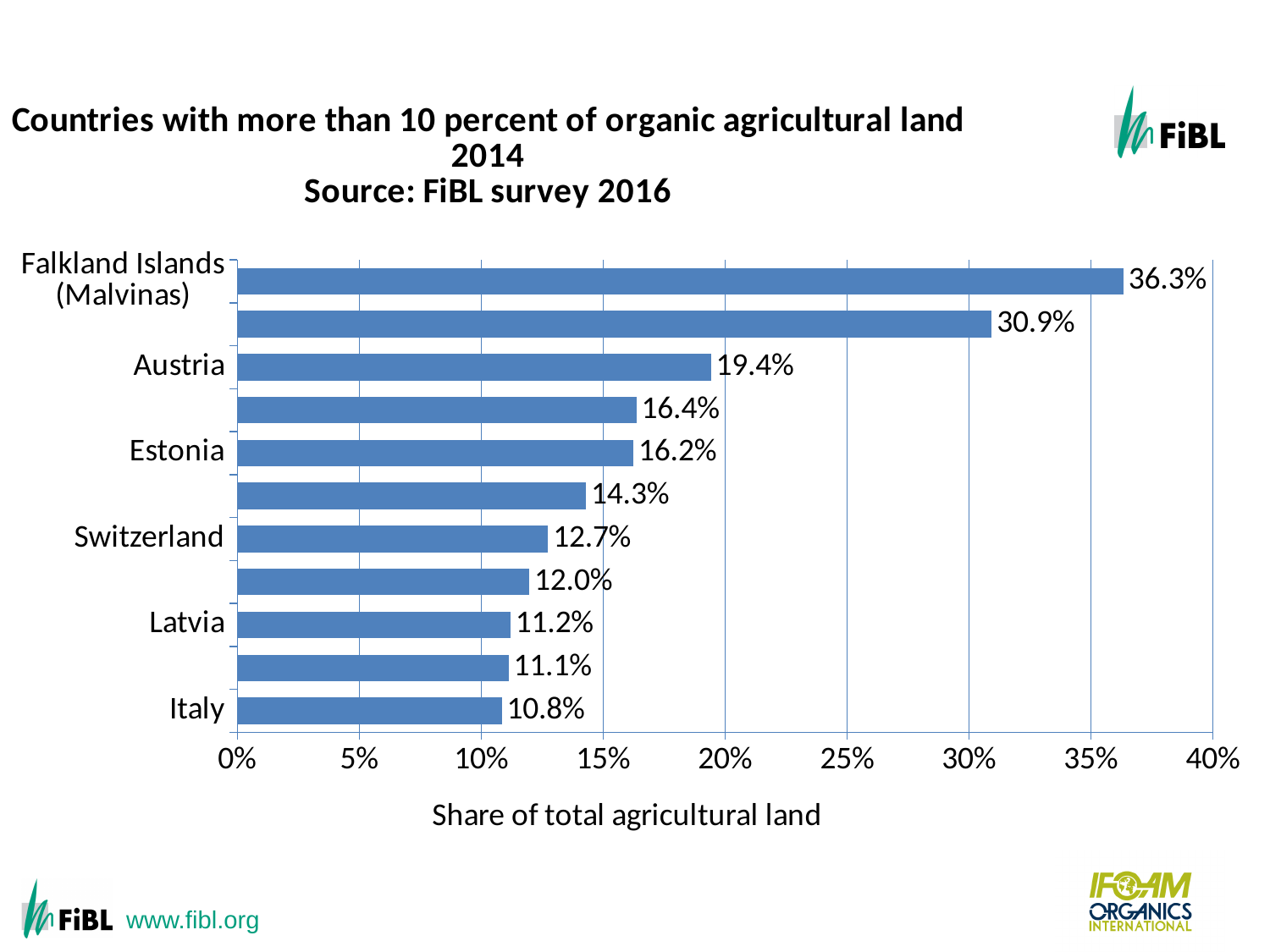
What is the difference between the values for Austria and Estonia? 3.2 percentage points How many bars are plotted in the chart? 11 What is the value for Italy? 10.8% What is the value for Austria? 19.4% Is the value for Latvia greater or less than 15%? less Which is larger, the value for Switzerland or the value for Latvia? Switzerland What is the label of the horizontal axis? Share of total agricultural land What is the value for Switzerland? 12.7% What kind of chart is shown on the slide? Bar chart Which country has the highest share of organic agricultural land? Falkland Islands (Malvinas) What is the value for Estonia? 16.2% Which labelled country has the lowest share of organic agricultural land? Italy